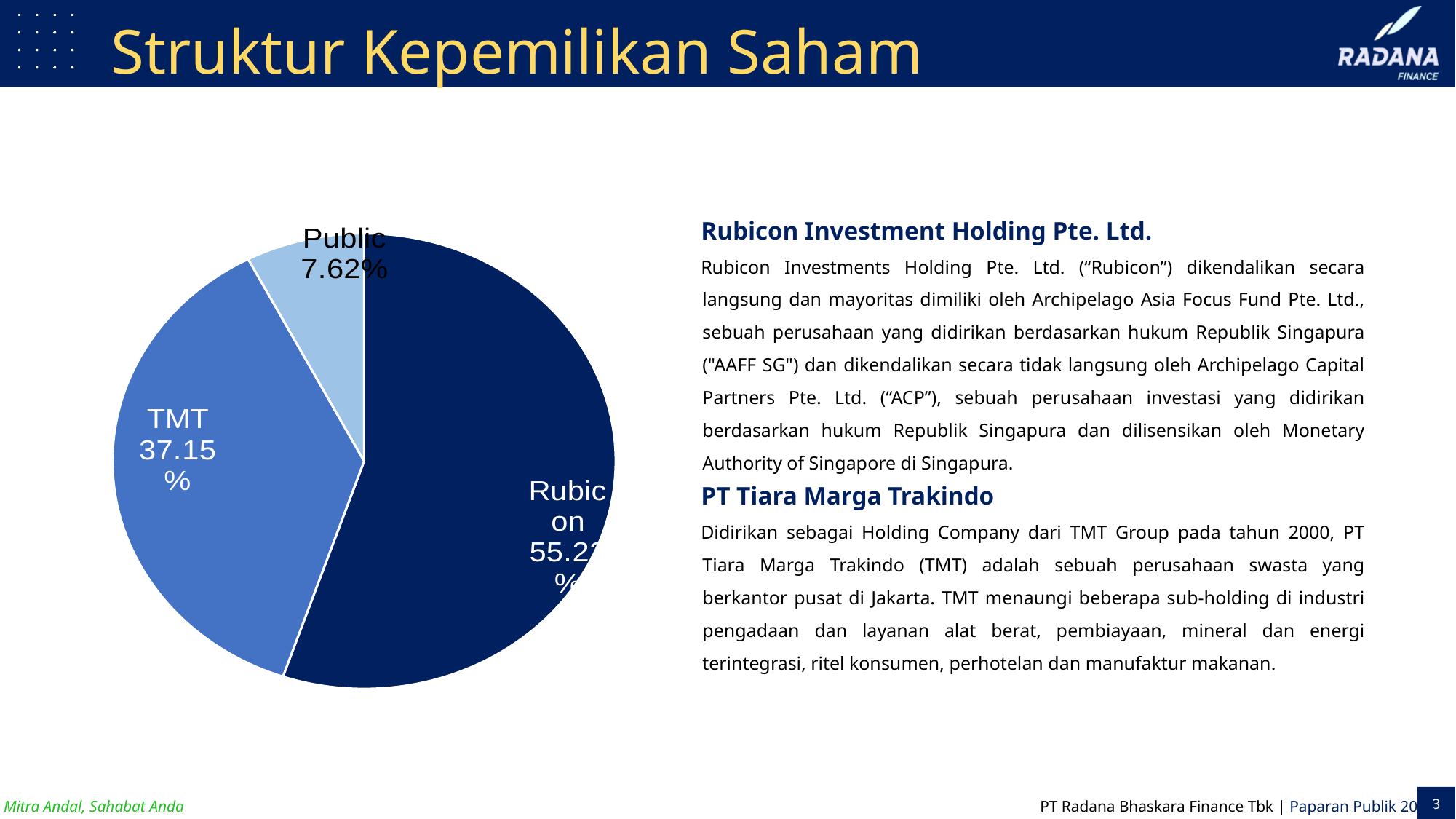
Which shareholder has the largest slice of the pie chart? Rubicon Which is larger in the pie chart, the TMT share or the Public share? TMT What kind of chart is shown on the slide? Pie chart Which is larger in the pie chart, the Rubicon share or the TMT share? Rubicon What colour is the Rubicon slice in the pie chart? Dark navy blue By how many percentage points does the TMT share exceed the Public share in the pie chart? 29.53% What share of ownership does Public hold according to the pie chart? 7.62% Which shareholder has the smallest slice of the pie chart? Public What share of ownership does TMT hold according to the pie chart? 37.15% How many slices does the pie chart have? 3 What is the title of the slide containing the pie chart? Struktur Kepemilikan Saham